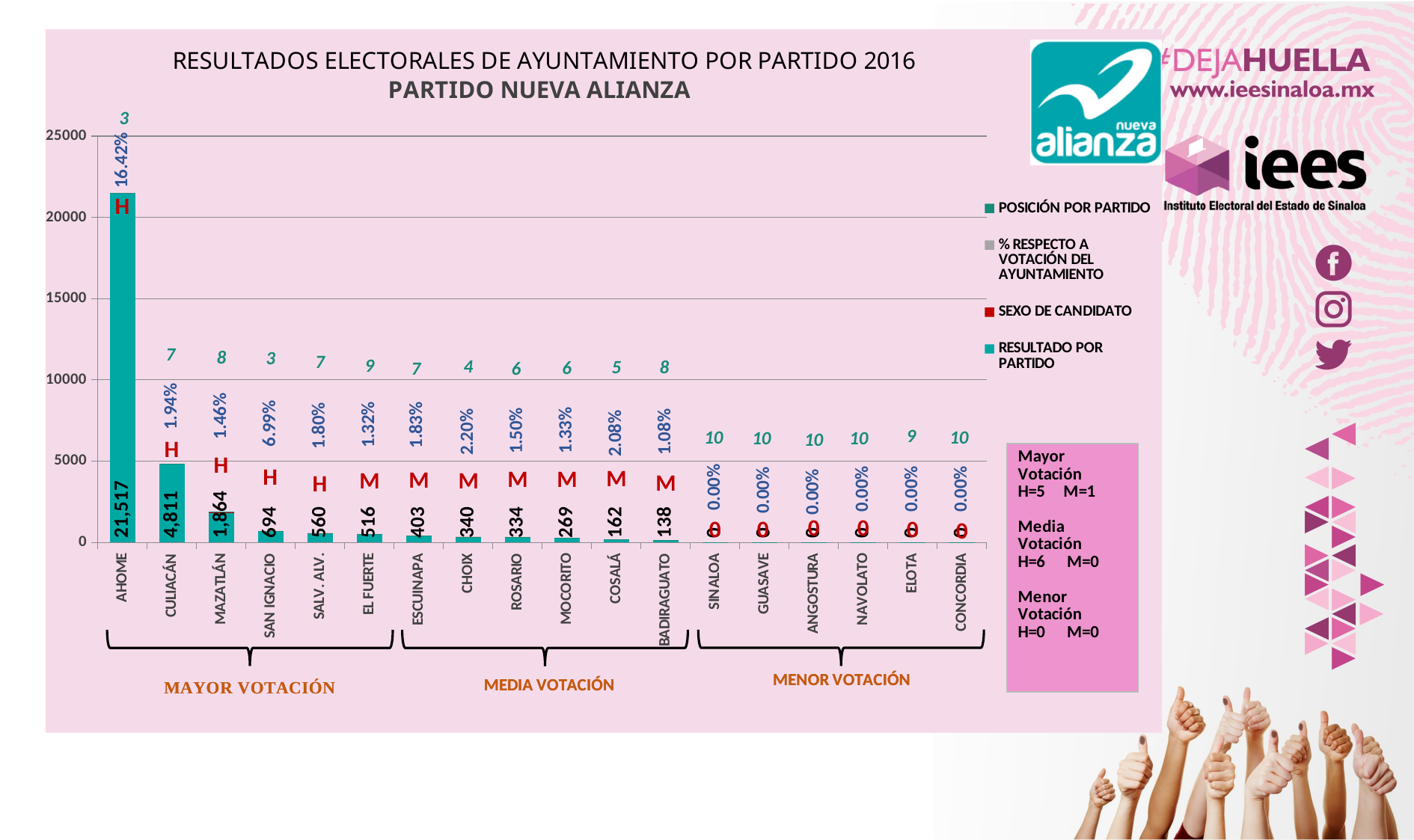
Is the RESULTADO POR PARTIDO value for AHOME greater or less than 20000? greater What is the SEXO DE CANDIDATO letter shown for MAZATLÁN? H What is the RESULTADO POR PARTIDO value for AHOME? 21,517 What kind of chart is shown on the slide? bar chart What is the RESULTADO POR PARTIDO value for CULIACÁN? 4,811 How many municipalities are shown on the x axis of the chart? 18 What is the POSICIÓN POR PARTIDO shown for CHOIX? 4 What is the difference between the RESULTADO POR PARTIDO values for CULIACÁN and MAZATLÁN? 2,947 Which municipality has the highest RESULTADO POR PARTIDO? AHOME What percentage (% RESPECTO A VOTACIÓN DEL AYUNTAMIENTO) is shown for SAN IGNACIO? 6.99% How many series does the legend list? 4 Which has a larger RESULTADO POR PARTIDO, ESCUINAPA or CHOIX? ESCUINAPA